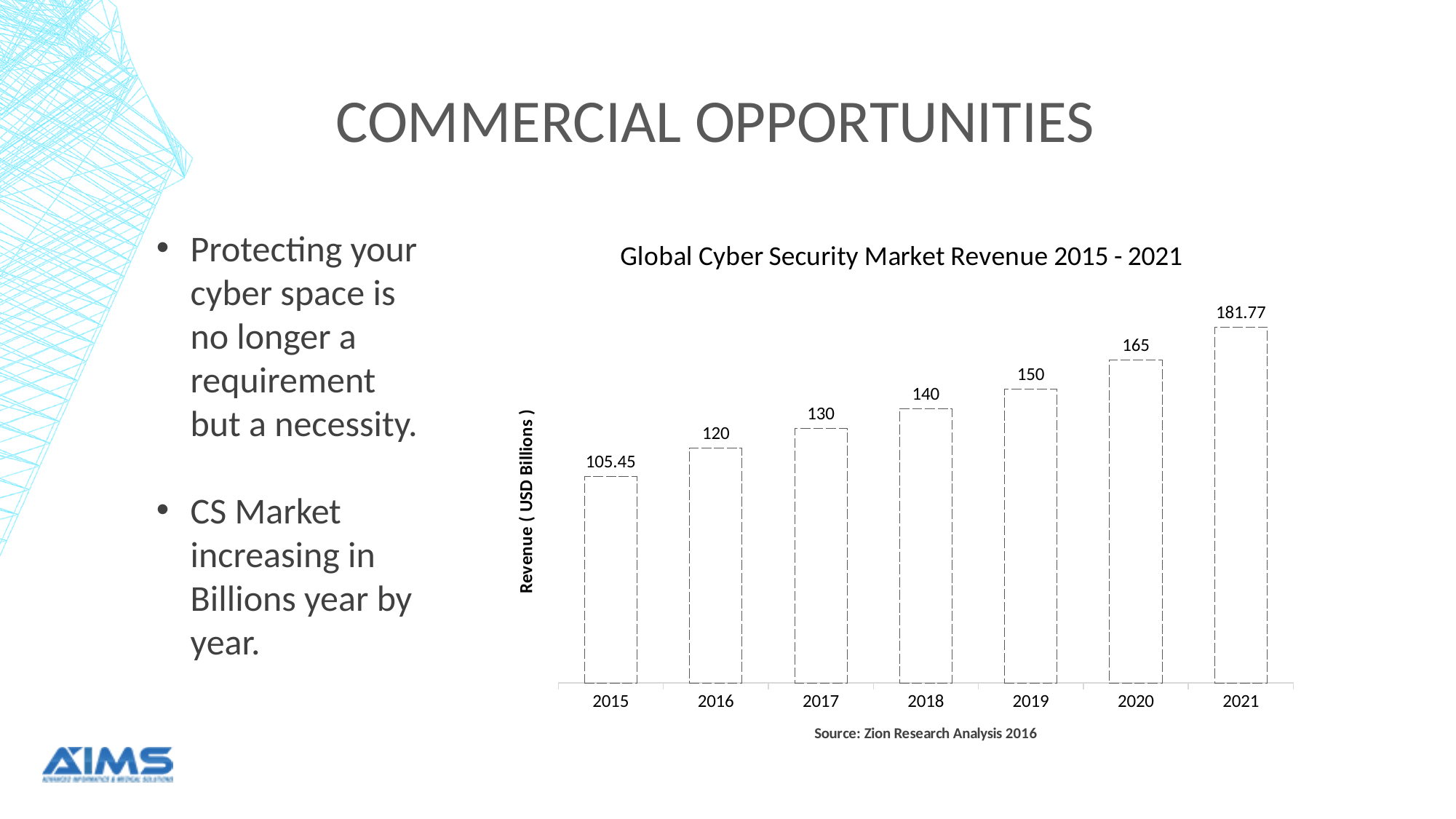
Which year has a larger revenue value, 2017 or 2019? 2019 What is the title of the chart? Global Cyber Security Market Revenue 2015 - 2021 Do the revenue values rise or fall from 2015 to 2021? Rise How many years are shown on the x axis of the chart? 7 What is the revenue value shown for 2021? 181.77 Which year has the highest revenue? 2021 What is the revenue value shown for 2018? 140 Which year has the lowest revenue? 2015 What is the revenue value shown for 2015? 105.45 What is the difference between the revenue values for 2020 and 2019? 15 What is the difference between the revenue values for 2021 and 2015? 76.32 What kind of chart is shown on the slide? Bar chart